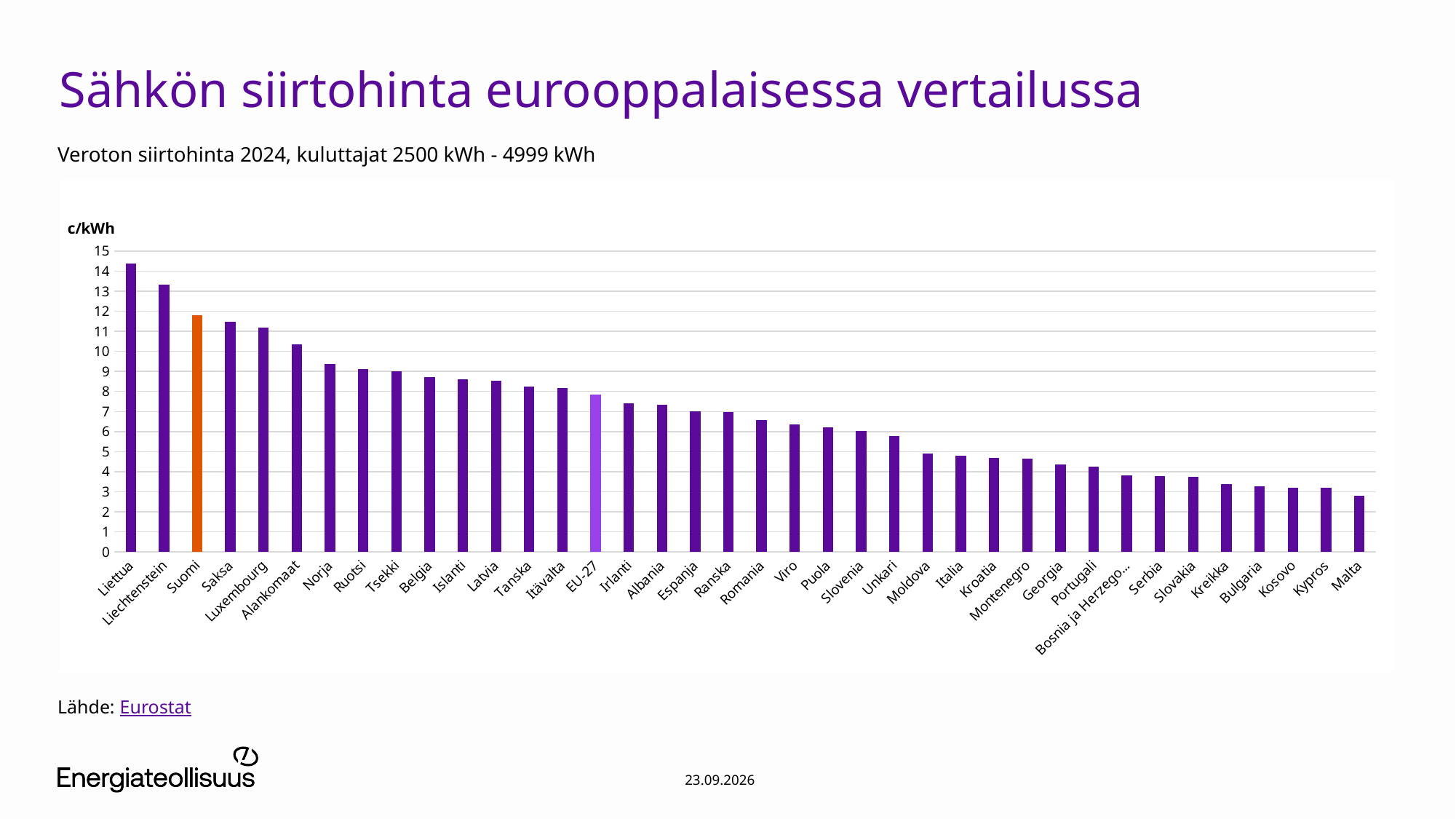
Is the value for Suomi greater or less than 11 c/kWh? greater Is the value for EU-27 greater or less than 7 c/kWh? greater Is the value for Liettua greater or less than 14 c/kWh? greater Which has a higher transmission price, Suomi or Ruotsi? Suomi Which country has the highest transmission price in the chart? Liettua Which bar is highlighted in orange in the chart? Suomi What kind of chart is shown on the slide? Bar chart Do the values rise or fall moving from left to right along the x axis? Fall Which country has the lowest transmission price in the chart? Malta How many bars (countries/regions) are shown in the chart? 38